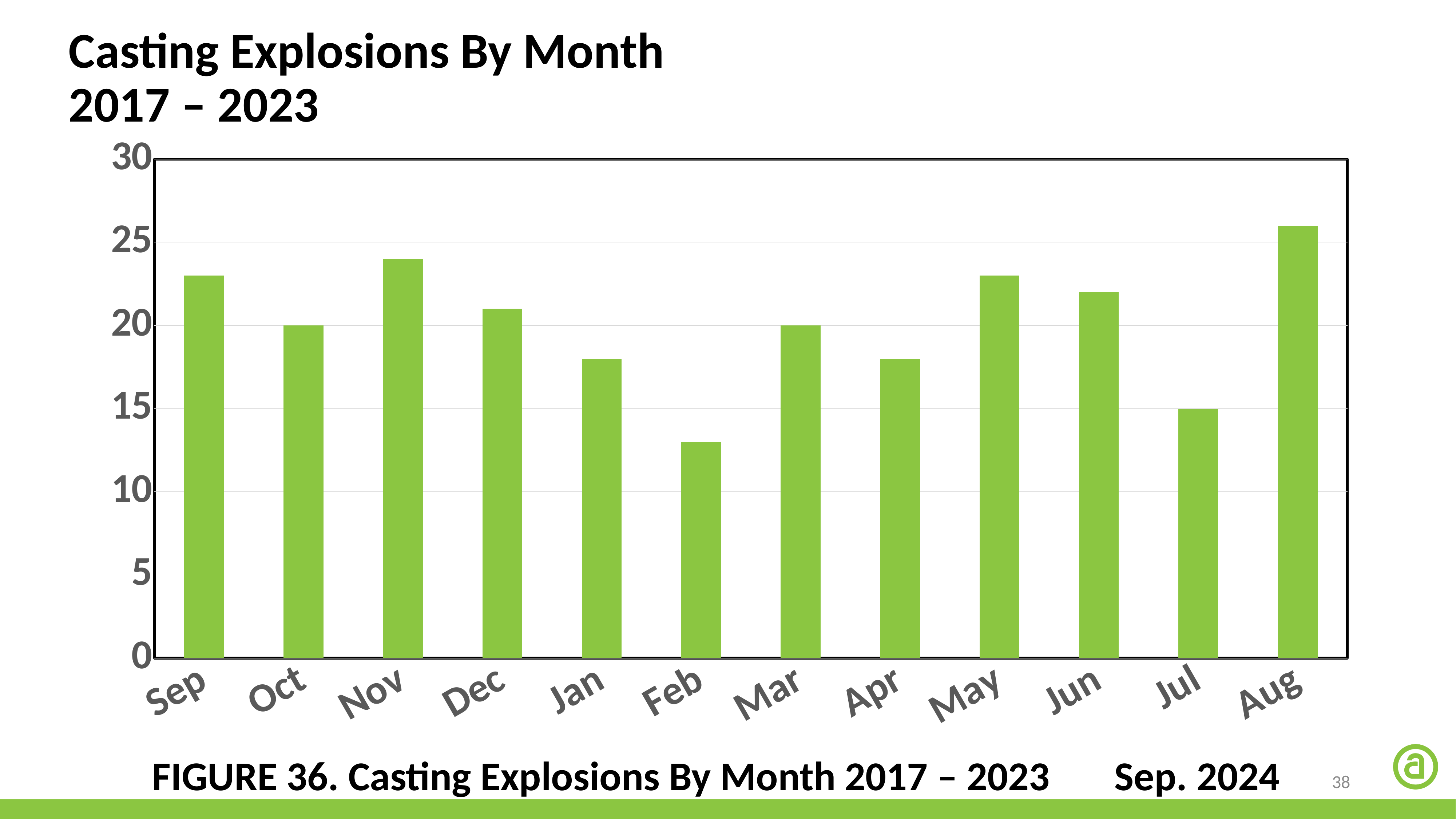
Which month has the lowest number of casting explosions? Feb Which month has the highest number of casting explosions? Aug What is the value for Jul? 15 How many months are shown on the x axis of the chart? 12 What is the value for Oct? 20 Is the value for Sep greater or less than 20? greater Is the value for Jan greater or less than 20? less What type of chart is shown on the slide? bar chart Is the value for Feb greater or less than 15? less What is the title of the chart? Casting Explosions By Month 2017 – 2023 Which month has more casting explosions, Nov or Dec? Nov